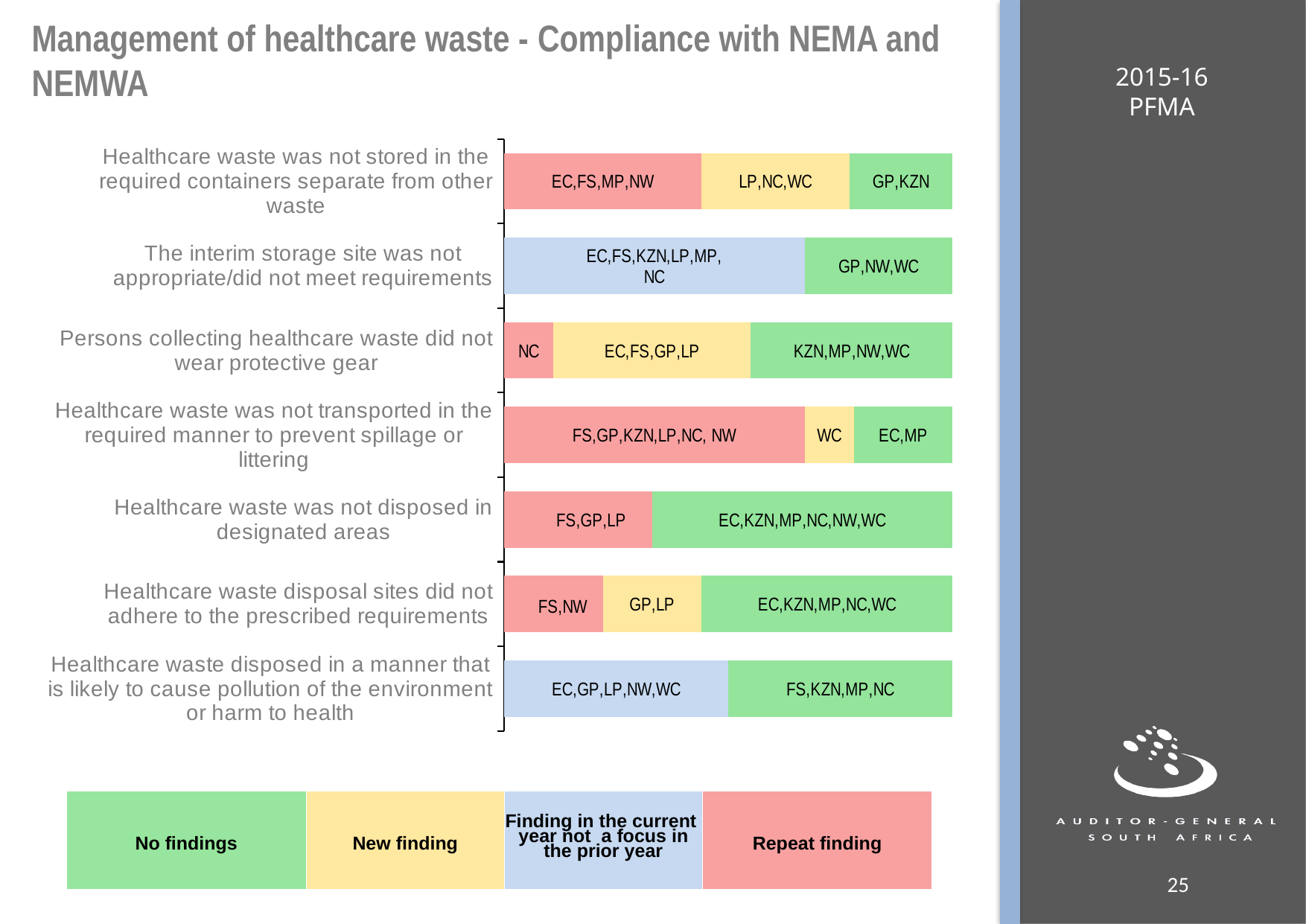
Which provinces are shown in the 'New finding' (yellow) segment for 'Healthcare waste was not stored in the required containers separate from other waste'? LP,NC,WC Which provinces are shown in the blue 'Finding in the current year not a focus in the prior year' segment for 'Healthcare waste disposed in a manner that is likely to cause pollution of the environment or harm to health'? EC,GP,LP,NW,WC Which province is the only one with a 'New finding' for 'Healthcare waste was not transported in the required manner to prevent spillage or littering'? WC Which provinces are shown in the 'No findings' (green) segment for 'Persons collecting healthcare waste did not wear protective gear'? KZN,MP,NW,WC Which provinces are shown in the 'Repeat finding' (red) segment for 'Healthcare waste was not disposed in designated areas'? FS,GP,LP Which finding has the most provinces in the 'Repeat finding' segment? Healthcare waste was not transported in the required manner to prevent spillage or littering What colour does the legend use for 'Repeat finding'? Red What kind of chart is shown on the slide? Stacked bar chart How many categories does the legend at the bottom of the chart list? 4 How many findings include a blue 'Finding in the current year not a focus in the prior year' segment? 2 How many compliance findings (categories) are listed on the chart? 7 Which finding has the most provinces in the 'No findings' segment? Healthcare waste was not disposed in designated areas